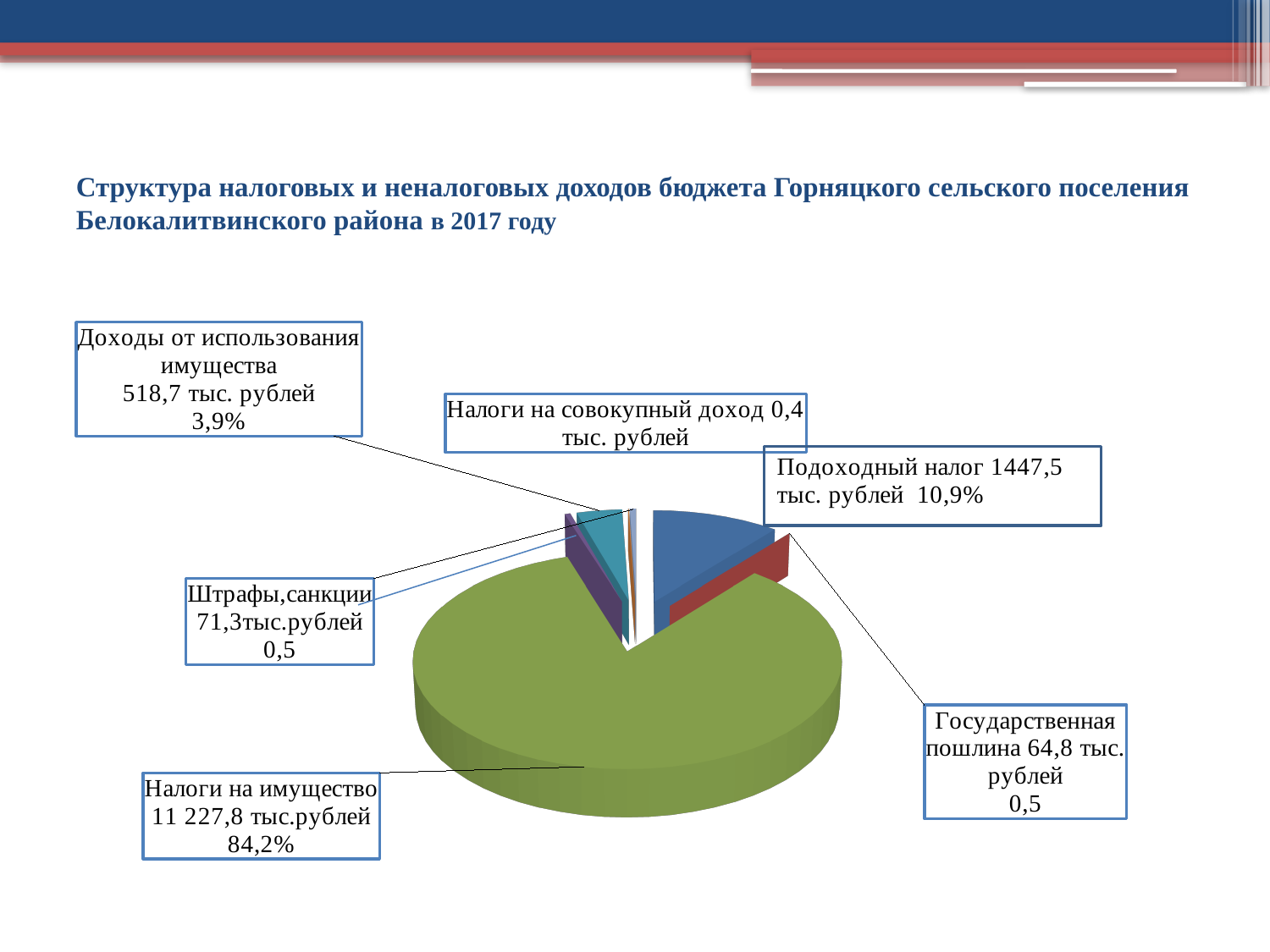
What is the difference between Подоходный налог and Доходы от использования имущества? 928,8 тыс. рублей What is the value for Подоходный налог? 1447,5 тыс. рублей What share of the pie does Налоги на имущество represent? 84,2% What is the value for Доходы от использования имущества? 518,7 тыс. рублей What is the value for Государственная пошлина? 64,8 тыс. рублей What kind of chart is shown on the slide? Pie chart Which category has the smallest value? Налоги на совокупный доход Which category has the largest share of the pie? Налоги на имущество What share of the pie does Подоходный налог represent? 10,9% What is the value for Налоги на имущество? 11 227,8 тыс.рублей Which is larger, Штрафы,санкции or Государственная пошлина? Штрафы,санкции